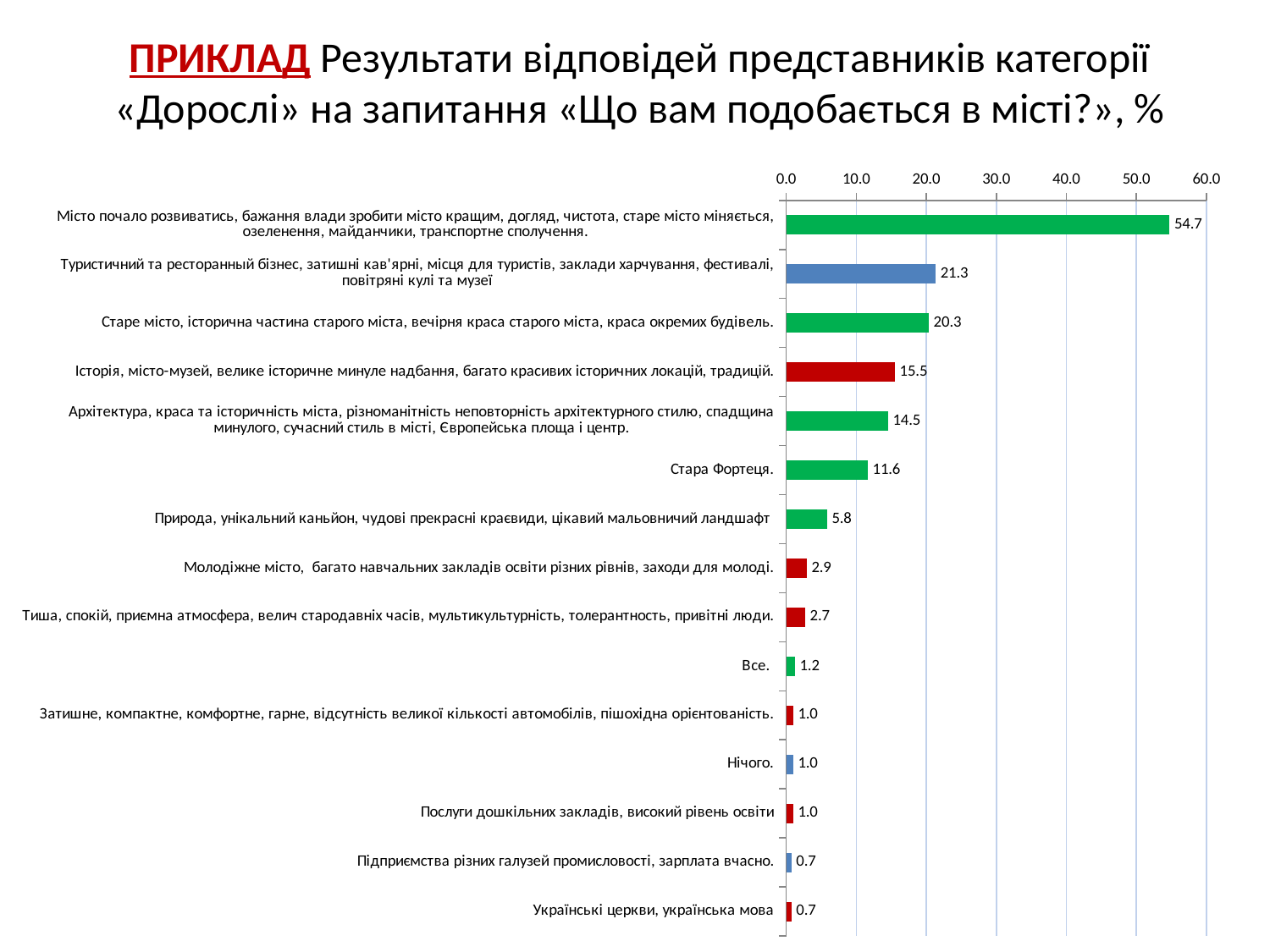
Which category has the highest value? Місто почало розвиватись, бажання влади зробити місто кращим, догляд, чистота, старе місто міняється, озеленення, майданчики, транспортне сполучення. What is the value for "Все."? 1.2 What is the difference between the highest value (54.7) and the value for "Стара Фортеця."? 43.1 Which is larger: the value for "Молодіжне місто, багато навчальних закладів освіти різних рівнів, заходи для молоді." or the value for "Природа, унікальний каньйон, чудові прекрасні краєвиди, цікавий мальовничий ландшафт"? Природа, унікальний каньйон, чудові прекрасні краєвиди, цікавий мальовничий ландшафт What is the difference between the value for "Туристичний та ресторанный бізнес, затишні кав'ярні, місця для туристів, заклади харчування, фестивалі, повітряні кулі та музеї" and the value for "Старе місто, історична частина старого міста, вечірня краса старого міста, краса окремих будівель."? 1.0 What is the value for "Стара Фортеця."? 11.6 What is the value for "Природа, унікальний каньйон, чудові прекрасні краєвиди, цікавий мальовничий ландшафт"? 5.8 How many categories are shown in the chart? 15 What is the maximum value shown on the horizontal axis? 60.0 Is the value for "Архітектура, краса та історичність міста, різноманітність неповторність архітектурного стилю, спадщина минулого, сучасний стиль в місті, Європейська площа і центр." greater or less than 20.0? less What is the value for "Історія, місто-музей, велике історичне минуле надбання, багато красивих історичних локацій, традицій."? 15.5 What type of chart is shown on the slide? bar chart